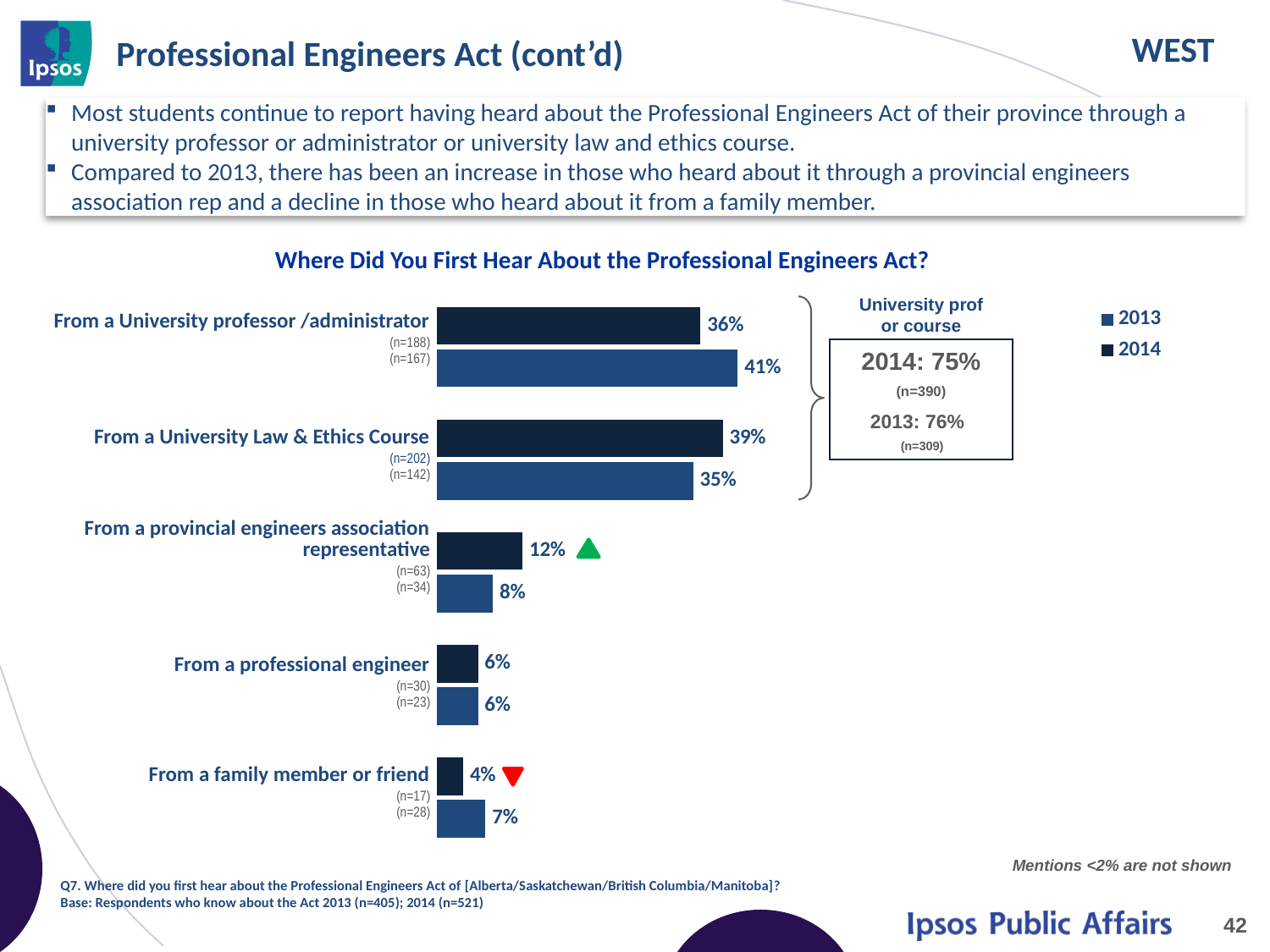
What is the 2014 value for 'From a provincial engineers association representative'? 12% Which category has the highest 2013 value? From a University professor /administrator According to the callout box, what is the combined 2014 value for 'University prof or course'? 75% How many categories are shown on the chart? 5 What is the 2014 value for 'From a University professor /administrator'? 36% For 'From a provincial engineers association representative', which year has the larger value, 2013 or 2014? 2014 Which category has the lowest 2014 value? From a family member or friend What kind of chart is shown on the slide? Bar chart What is the difference between the 2013 and 2014 values for 'From a University professor /administrator'? 5% What is the 2013 value for 'From a University Law & Ethics Course'? 35% What is the 2013 value for 'From a family member or friend'? 7% How many series does the legend list? 2